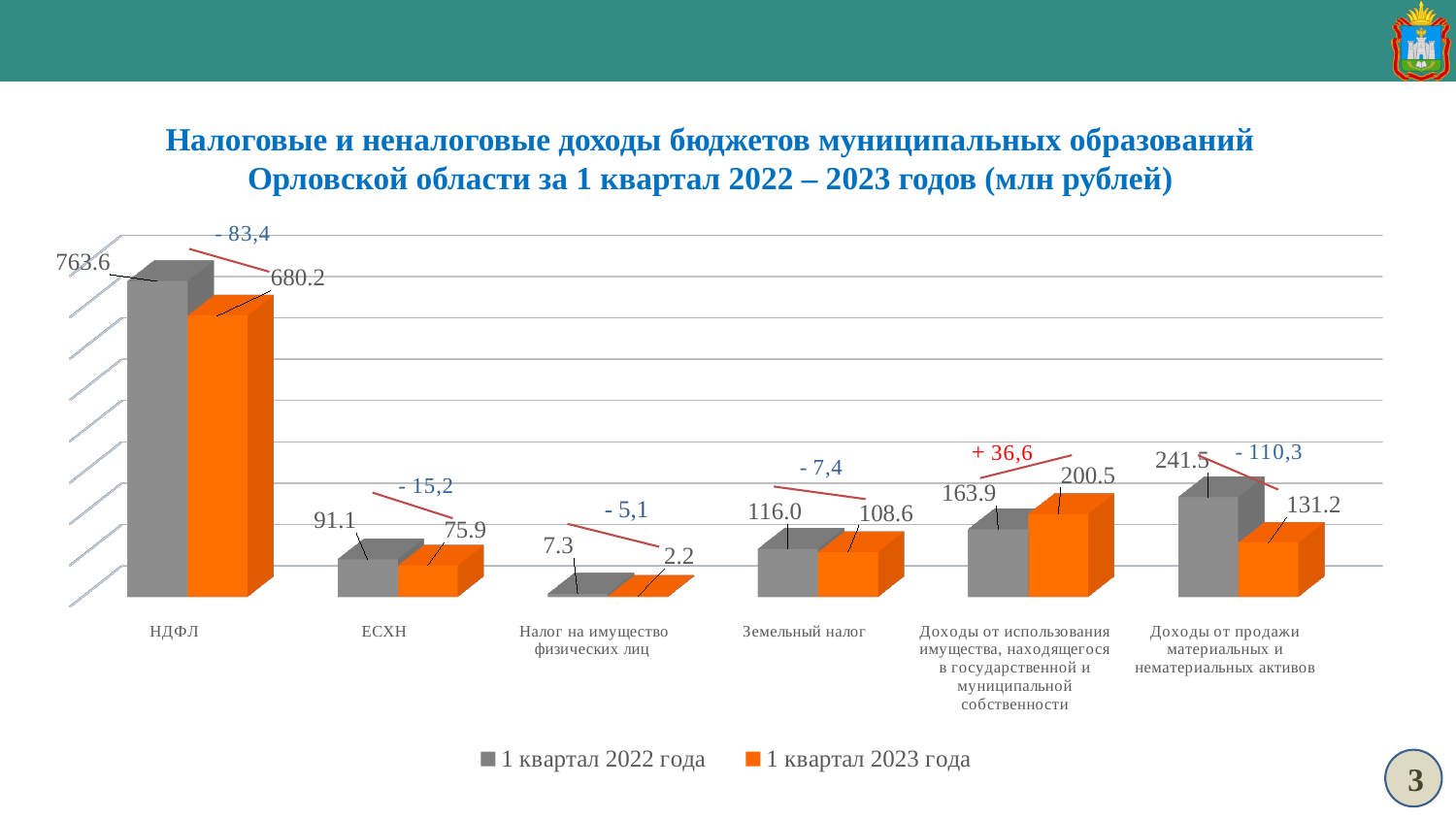
Which category has the highest value in the series '1 квартал 2022 года'? НДФЛ What is the value for 'Доходы от использования имущества, находящегося в государственной и муниципальной собственности' in the series '1 квартал 2022 года'? 163.9 What kind of chart is shown on the slide? Bar chart How many series does the legend list? 2 What is the value for Земельный налог in the series '1 квартал 2023 года'? 108.6 Which category is the only one where the 2023 value is higher than the 2022 value? Доходы от использования имущества, находящегося в государственной и муниципальной собственности What is the value for НДФЛ in the series '1 квартал 2023 года'? 680.2 How many categories are shown on the x axis of the chart? 6 Which category has the lowest value in the series '1 квартал 2023 года'? Налог на имущество физических лиц For 'Доходы от продажи материальных и нематериальных активов', which series has the larger value: '1 квартал 2022 года' or '1 квартал 2023 года'? 1 квартал 2022 года What is the difference between the 2022 and 2023 values for ЕСХН? 15.2 What is the value for НДФЛ in the series '1 квартал 2022 года'? 763.6